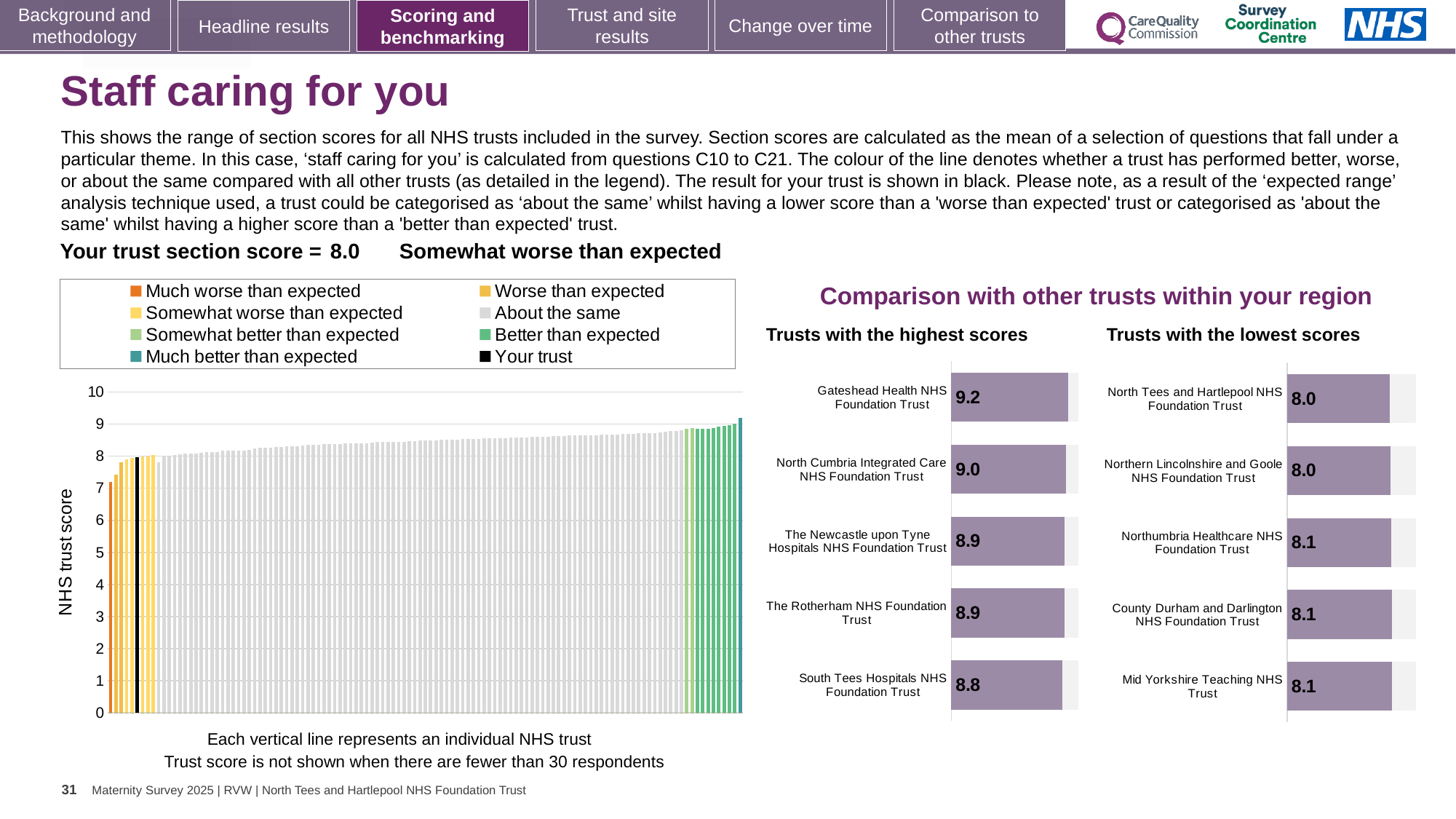
In the 'Trusts with the highest scores' chart, which has the larger score: Gateshead Health NHS Foundation Trust or North Cumbria Integrated Care NHS Foundation Trust? Gateshead Health NHS Foundation Trust In the 'Trusts with the highest scores' chart, what is the difference between the scores of Gateshead Health NHS Foundation Trust and South Tees Hospitals NHS Foundation Trust? 0.4 In the main 'NHS trust score' chart, do the trust scores rise or fall from left to right? rise In the 'Trusts with the highest scores' chart, which trust has the highest score? Gateshead Health NHS Foundation Trust In the main 'NHS trust score' chart, what is the section score for your trust? 8.0 How many entries does the legend of the main 'NHS trust score' chart list? 8 In the 'Trusts with the lowest scores' chart, what is the score for Northern Lincolnshire and Goole NHS Foundation Trust? 8.0 In the 'Trusts with the highest scores' chart, which trust has the lowest score? South Tees Hospitals NHS Foundation Trust In the 'Trusts with the lowest scores' chart, what is the score for Northumbria Healthcare NHS Foundation Trust? 8.1 In the main 'NHS trust score' chart, is the value for your trust (the black line) greater or less than 9? less How many trusts are listed in the 'Trusts with the lowest scores' chart? 5 In the 'Trusts with the highest scores' chart, what is the score for Gateshead Health NHS Foundation Trust? 9.2